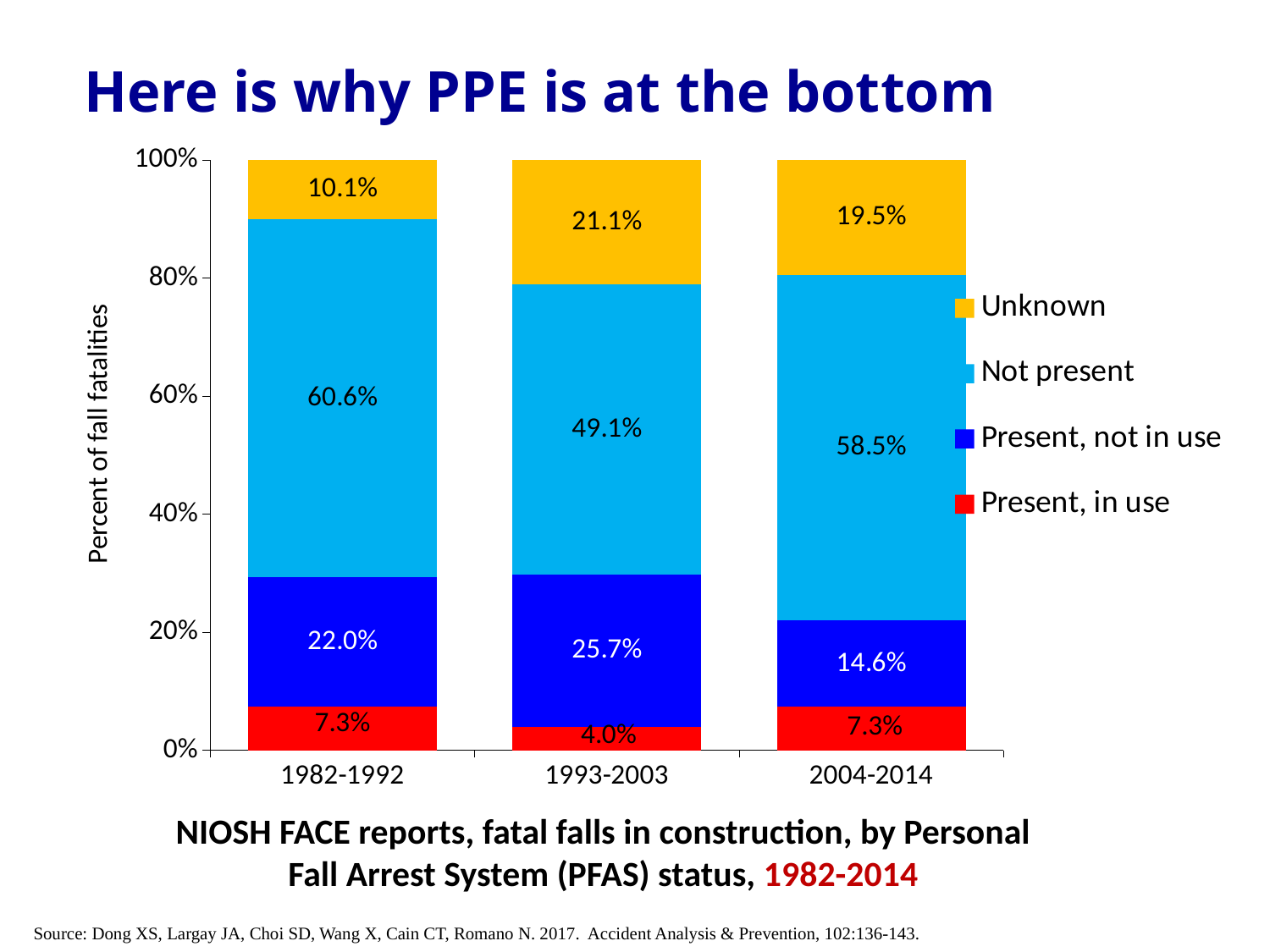
What is the label on the vertical axis? Percent of fall fatalities What kind of chart is shown on the slide? Stacked bar chart What is the 'Unknown' share for 2004-2014? 19.5% How many time periods are shown on the x axis? 3 Which period has the lowest 'Present, in use' share? 1993-2003 What is the 'Present, in use' value for the 1993-2003 period? 4.0% How many series does the legend list? 4 Which period has the highest 'Unknown' share? 1993-2003 What percentage of fall fatalities in 1982-1992 had a PFAS 'Not present'? 60.6% What is the 'Present, not in use' value for 2004-2014? 14.6% Which period has the larger 'Present, not in use' share, 1982-1992 or 1993-2003? 1993-2003 By how many percentage points does the 'Not present' share in 1982-1992 exceed that in 1993-2003? 11.5 percentage points